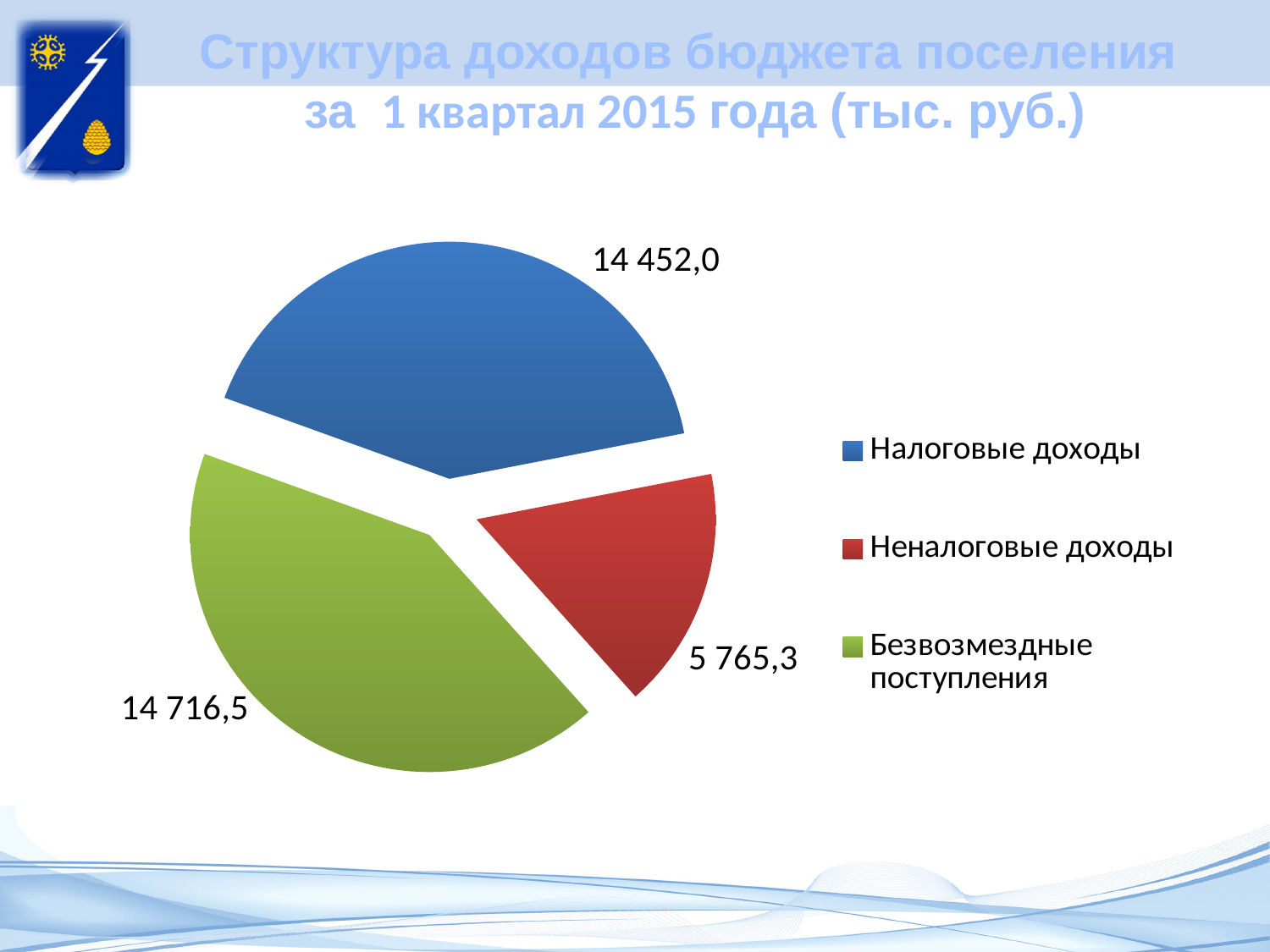
What kind of chart is shown on the slide? Pie chart What is the value for Неналоговые доходы? 5 765,3 What is the difference between Безвозмездные поступления and Налоговые доходы? 264,5 What is the difference between Налоговые доходы and Неналоговые доходы? 8 686,7 Which category has the largest value? Безвозмездные поступления Which is larger, Налоговые доходы or Неналоговые доходы? Налоговые доходы What colour is the slice for Неналоговые доходы? Red What is the value for Налоговые доходы? 14 452,0 What is the value for Безвозмездные поступления? 14 716,5 Which category has the smallest value? Неналоговые доходы How many slices does the pie chart have? 3 How many entries does the legend list? 3